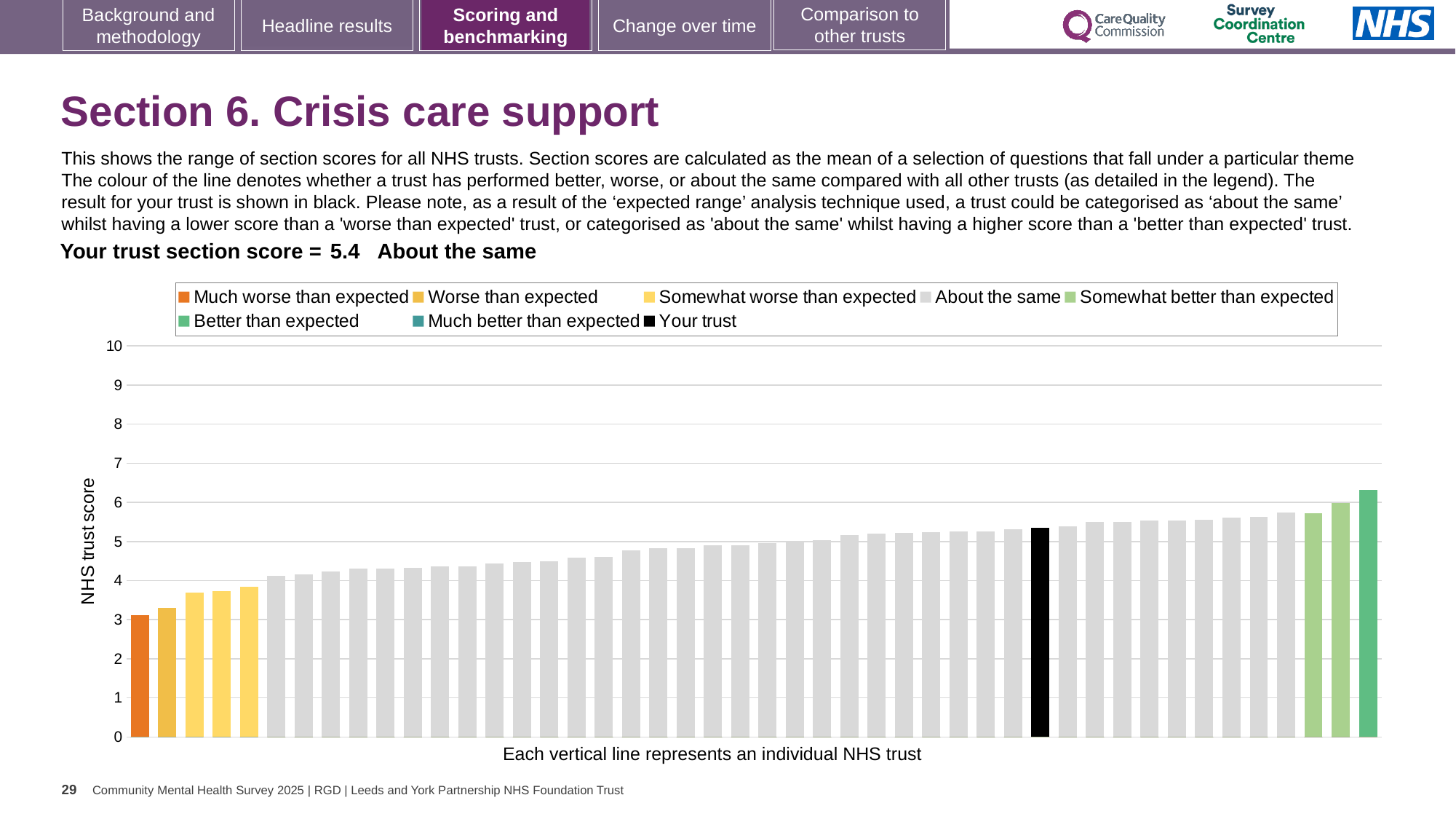
Which category is your trust placed in for this section? About the same Is the value of the highest bar in the chart greater or less than 6? greater Is the value of the black 'Your trust' bar greater or less than 5? greater What kind of chart is shown on the slide? Bar chart Do the bar values rise or fall from left to right along the x axis? Rise What is the section score for your trust shown on the slide? 5.4 Is the value of the lowest bar in the chart greater or less than 4? less Which legend category does the lowest-scoring trust belong to? Much worse than expected What is the label on the vertical axis of the chart? NHS trust score Which legend category does the highest-scoring trust belong to? Better than expected How many entries does the chart legend list? 8